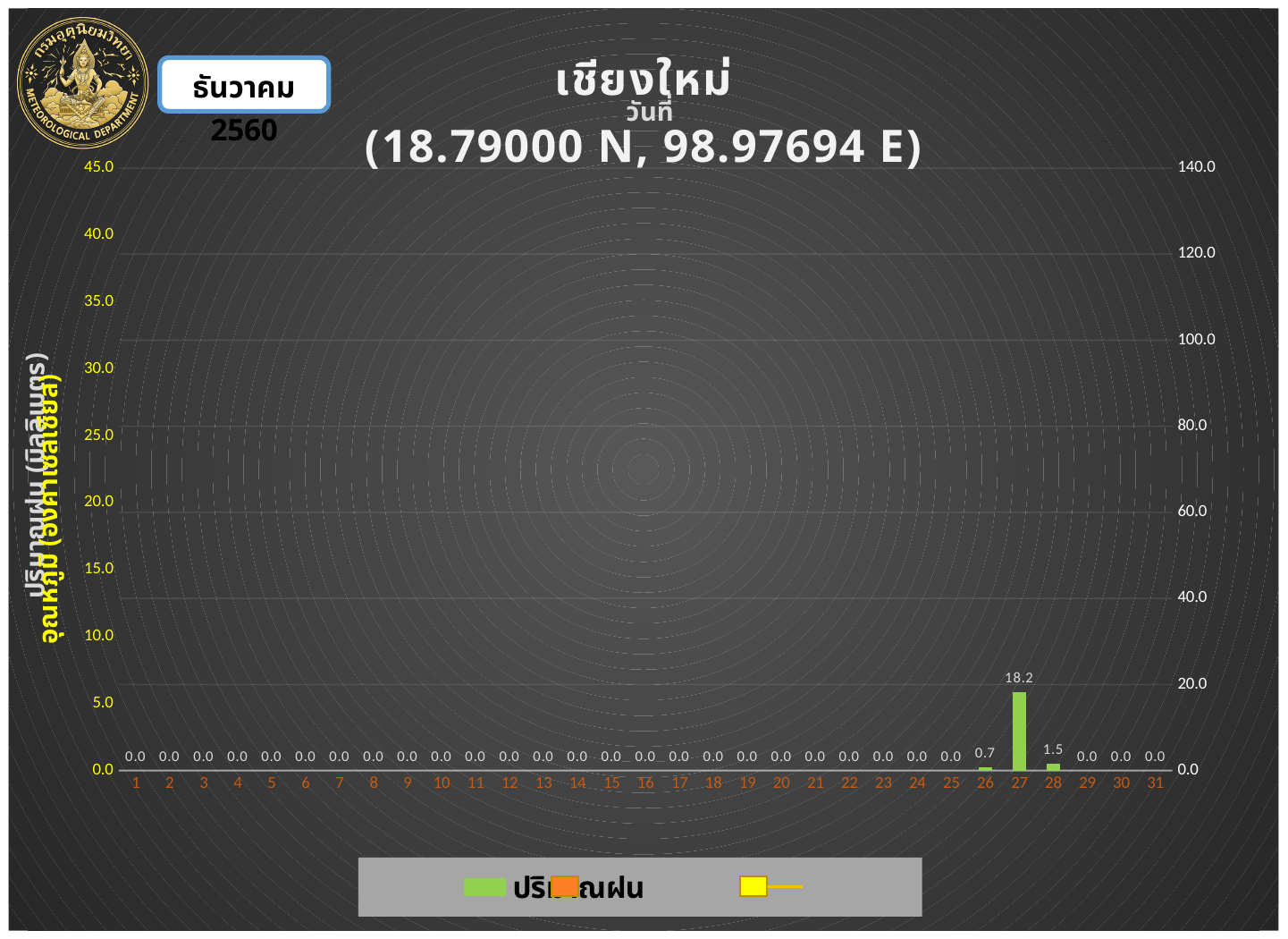
Which is larger, the rainfall value for day 26 or for day 28? day 28 What is the rainfall value shown for day 28? 1.5 How many days (categories) are shown on the x axis? 31 What kind of chart is used to show the rainfall values? bar chart What is the rainfall value shown for day 15? 0.0 Which day has the highest rainfall value? 27 What is the highest tick value shown on the right-hand axis? 140.0 Is the rainfall value for day 27 greater or less than 20.0 on the right axis? less What is the difference between the rainfall values for day 27 and day 28? 16.7 What is the rainfall value shown for day 27? 18.2 What is the rainfall value shown for day 26? 0.7 What is the difference between the rainfall values for day 28 and day 26? 0.8